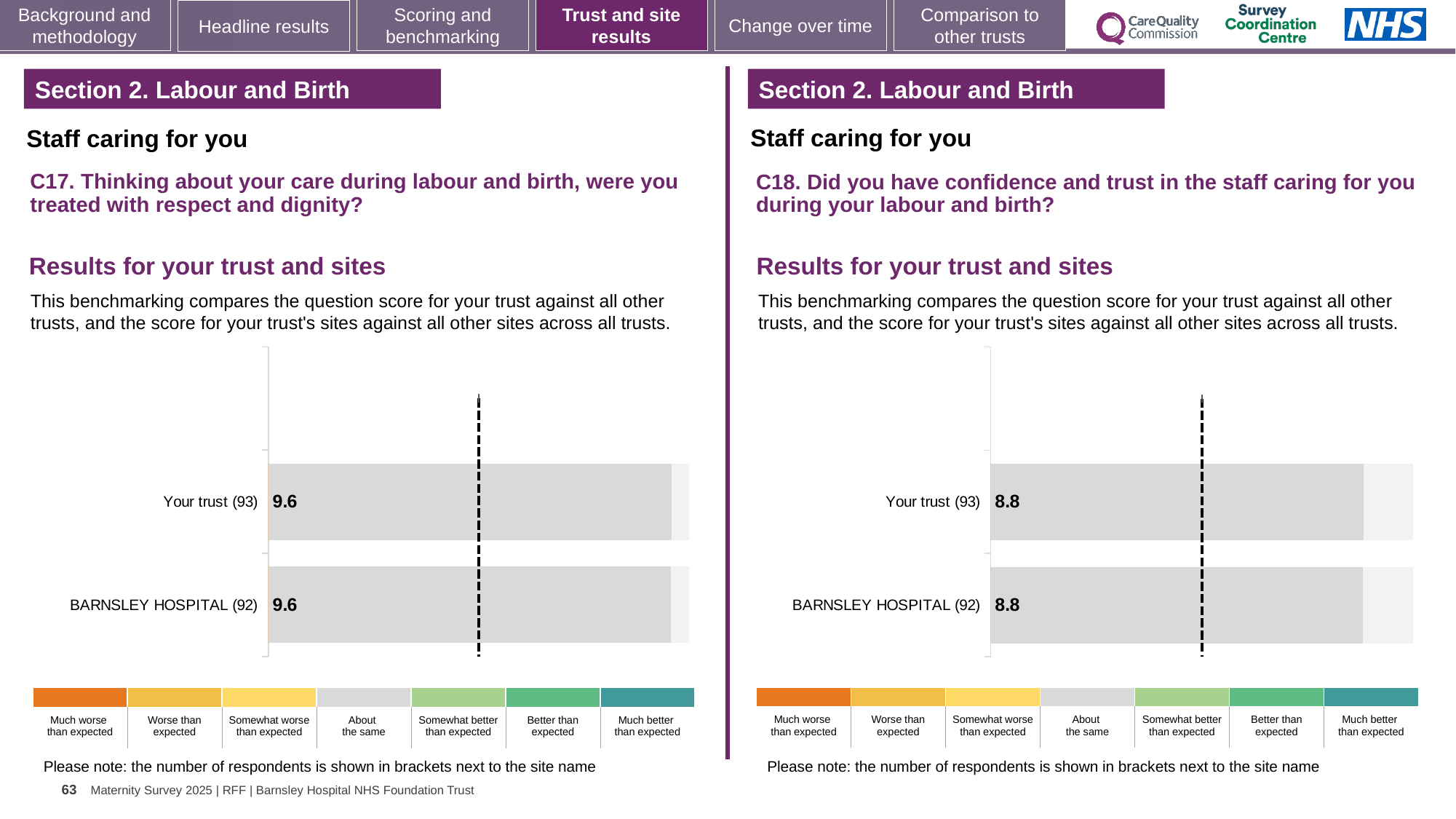
In the right chart (C18), how many respondents are shown in brackets for BARNSLEY HOSPITAL? 92 In the left chart (C17), what is the score for Your trust? 9.6 In the right chart (C18), what is the difference between the Your trust score and the BARNSLEY HOSPITAL score? 0 In the right chart (C18), what is the score for BARNSLEY HOSPITAL? 8.8 In the right chart (C18), what is the score for Your trust? 8.8 In the left chart (C17), what is the difference between the Your trust score and the BARNSLEY HOSPITAL score? 0 How many bars are plotted in the left chart (C17)? 2 In the left chart (C17), what is the score for BARNSLEY HOSPITAL? 9.6 In the left chart (C17), how many respondents are shown in brackets for Your trust? 93 Is the Your trust score in the left chart (C17) larger or smaller than the Your trust score in the right chart (C18)? Larger What kind of chart is used in the left chart (C17)? Bar chart How many bars are plotted in the right chart (C18)? 2